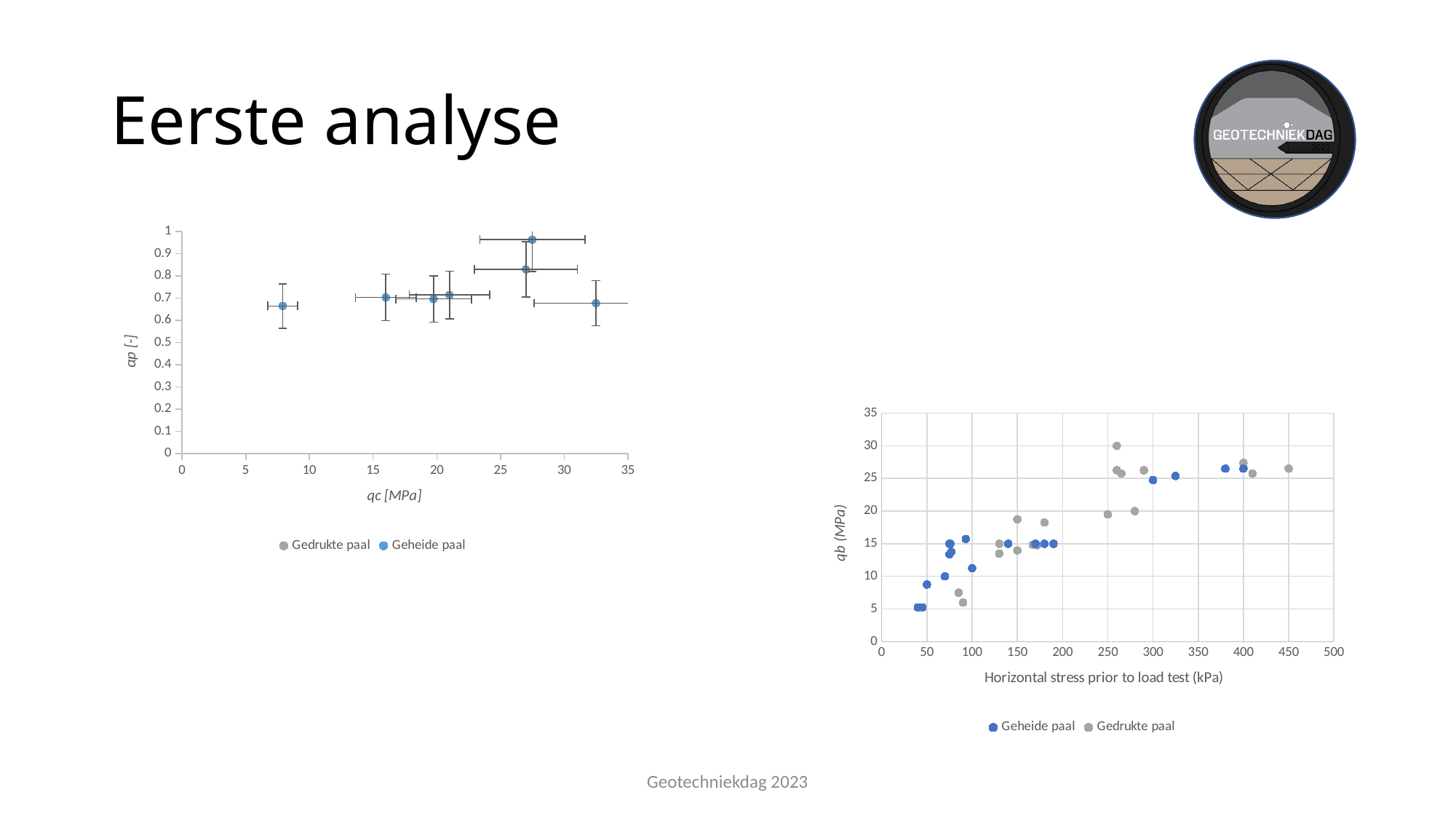
How many data points are plotted in the left chart (qp vs qc)? 7 In the left chart (qp vs qc), is the qp value of the highest point greater or less than 0.9? greater In the right chart (qb vs horizontal stress), are the qb values of the points at a horizontal stress of about 40 kPa greater or less than 10? less In the left chart (qp vs qc), is the qp value of the point at qc of about 32.5 MPa greater or less than 0.8? less How many series does the legend of the left chart (qp vs qc) list? 2 How many series does the legend of the right chart (qb vs horizontal stress) list? 2 What are the two legend entries of the right chart (qb vs horizontal stress)? Geheide paal, Gedrukte paal What is the x-axis title of the right chart? Horizontal stress prior to load test (kPa) What kind of chart is the left chart (qp vs qc)? scatter chart In the right chart (qb vs horizontal stress), does qb generally rise or fall as horizontal stress increases? rise